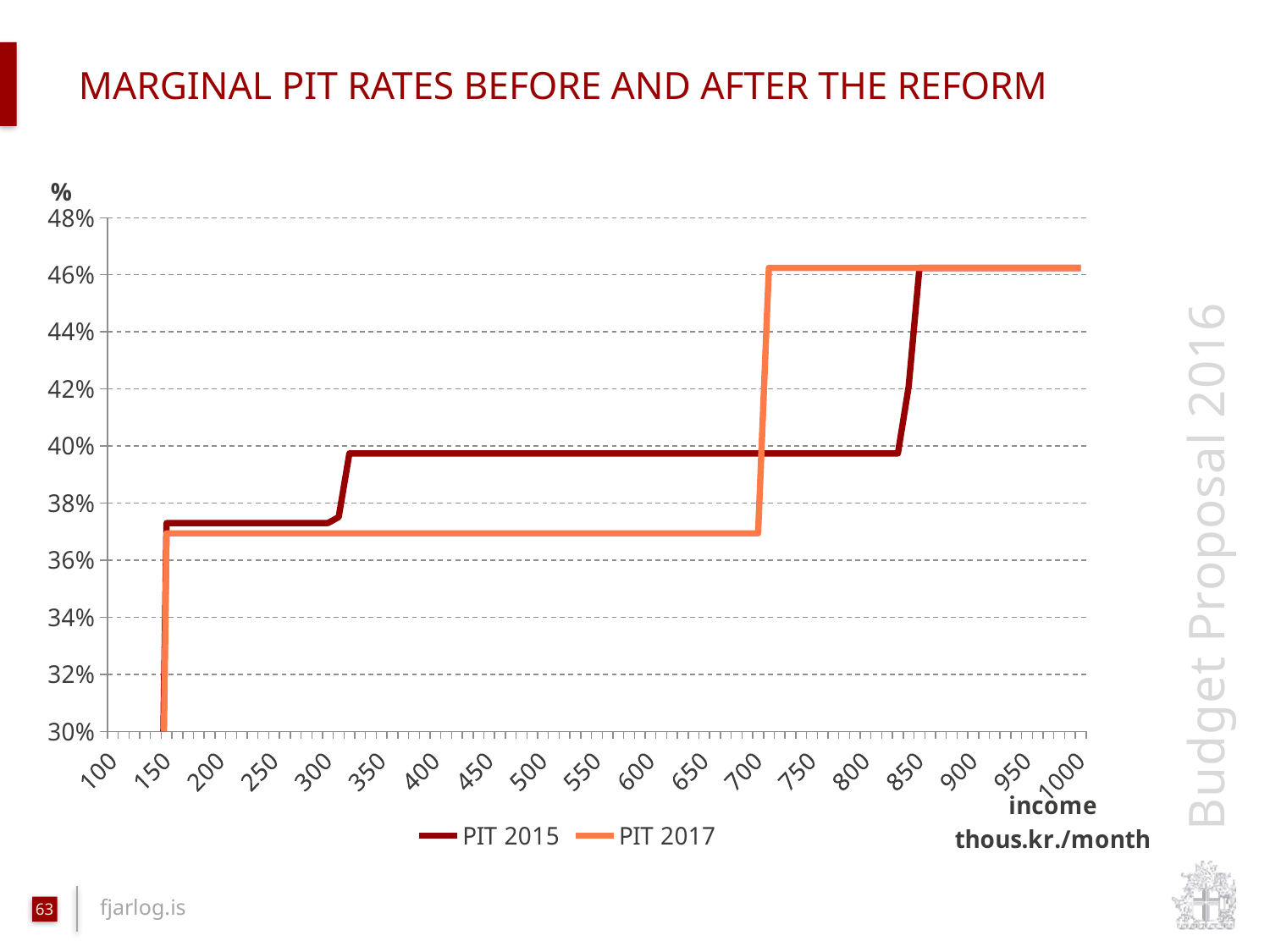
Is the PIT 2015 rate at an income of 500 greater or less than 38%? greater What kind of chart is shown on the slide? line chart Do the PIT 2017 rates rise or fall as income increases along the x axis? rise Is the PIT 2017 rate at an income of 500 greater or less than 38%? less At an income of 750, which series has the higher rate, PIT 2015 or PIT 2017? PIT 2017 What are the two series named in the legend? PIT 2015 and PIT 2017 Is the PIT 2017 rate at an income of 500 greater or less than 36%? greater What is the title of the chart? MARGINAL PIT RATES BEFORE AND AFTER THE REFORM At an income of 500, which series has the higher rate, PIT 2015 or PIT 2017? PIT 2015 How many series does the legend list? 2